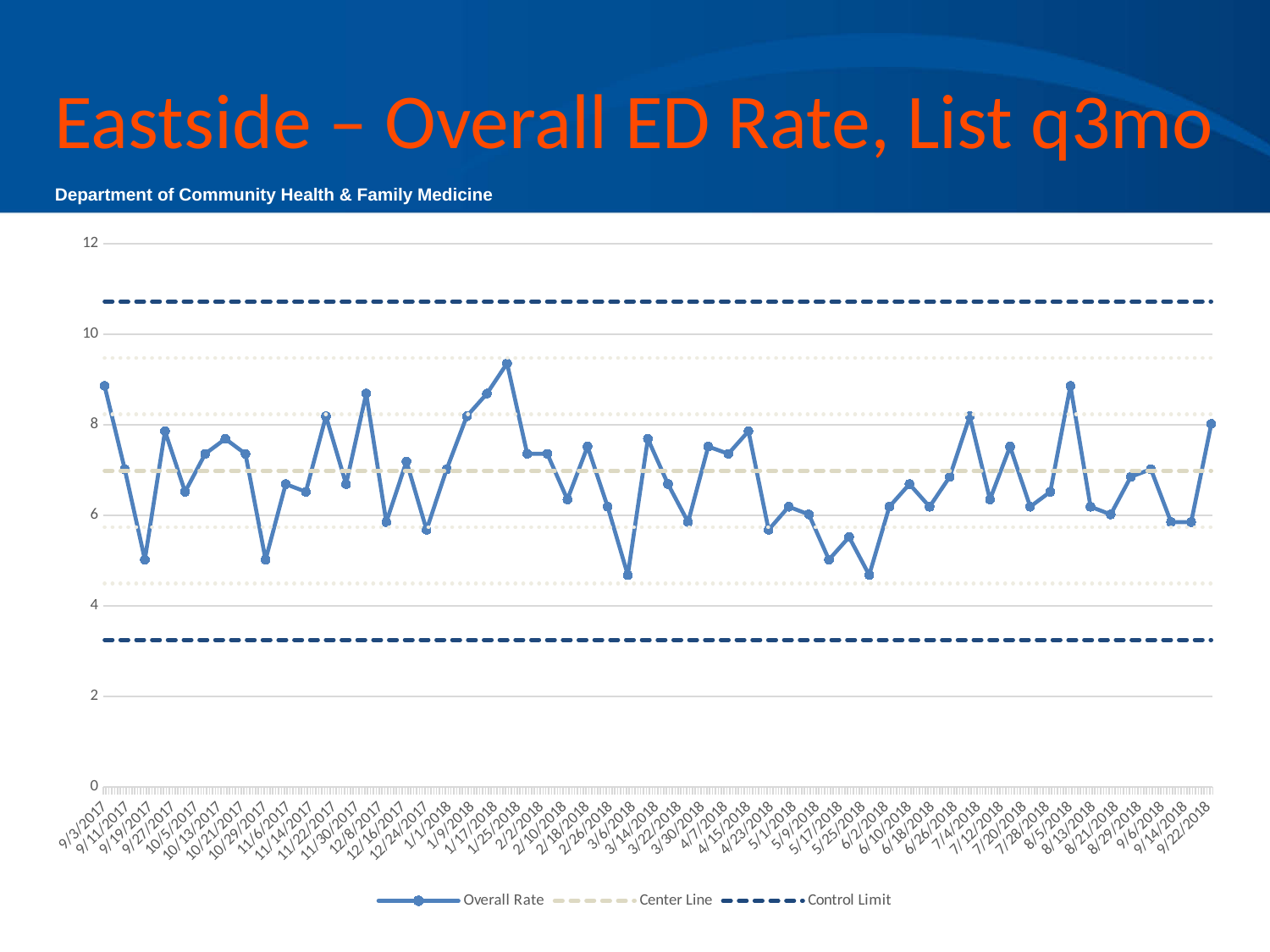
How many series does the chart legend list? 3 What is the title shown above the chart on the slide? Eastside – Overall ED Rate, List q3mo Is the upper Control Limit line greater or less than 10? greater Is the Overall Rate value for 9/3/2017 greater or less than 8? greater What kind of chart is shown on the slide? line chart Which has the larger Overall Rate value, 9/3/2017 or 9/19/2017? 9/3/2017 What are the three series named in the chart legend? Overall Rate, Center Line, Control Limit Is the lower Control Limit line greater or less than 4? less